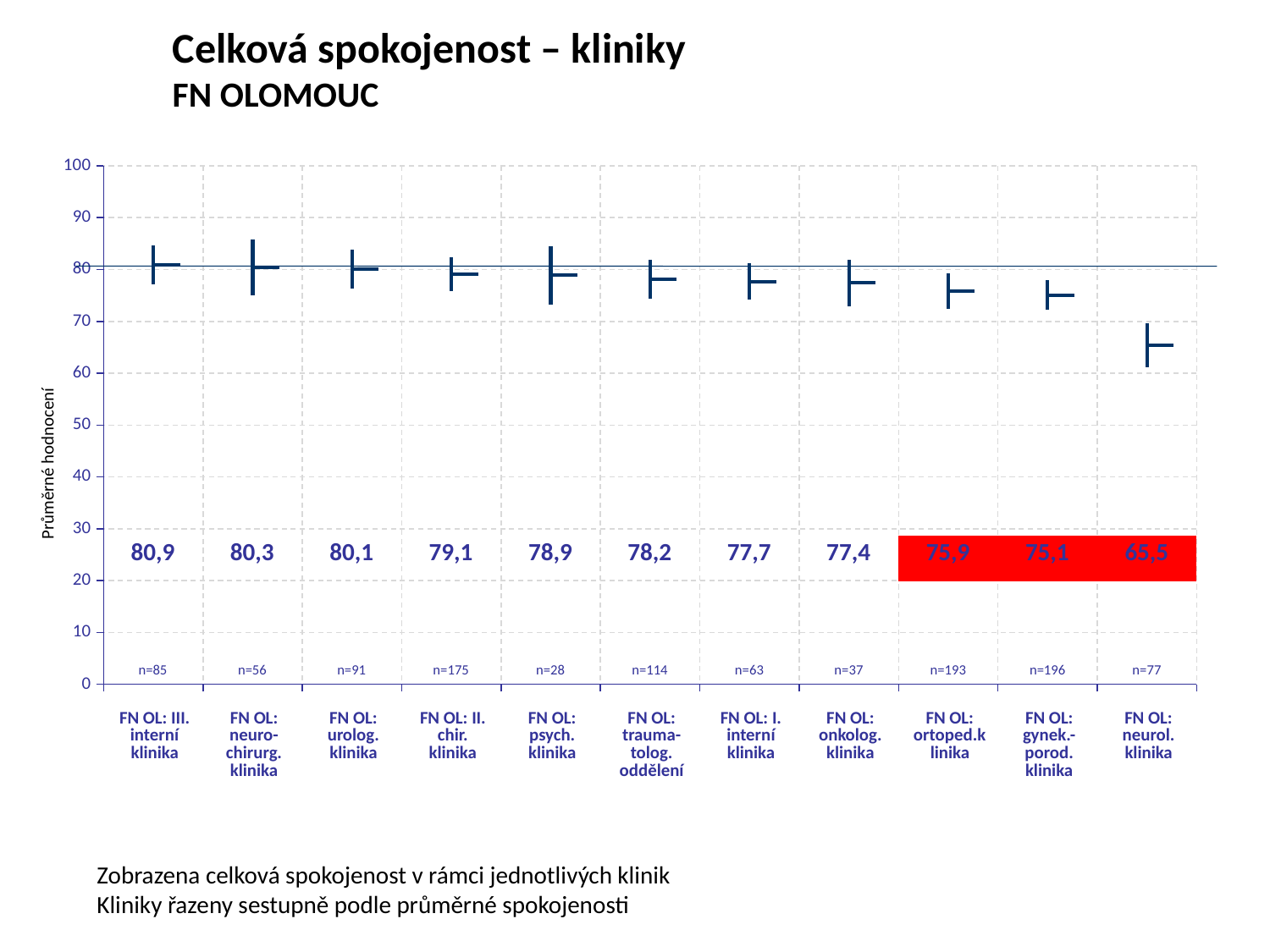
How many clinics have their value labels highlighted with a red background? 3 What is the sample size (n) shown for FN OL: gynek.-porod. klinika? n=196 Is the average rating for FN OL: neurol. klinika greater or less than 70? less Do the average ratings rise or fall from left to right along the x axis? fall What is the average rating (průměrné hodnocení) for FN OL: III. interní klinika? 80,9 Which clinic has the highest average rating? FN OL: III. interní klinika What is the average rating for FN OL: neurol. klinika? 65,5 What is the difference between the average ratings of FN OL: III. interní klinika and FN OL: neurol. klinika? 15,4 What is the average rating for FN OL: psych. klinika? 78,9 How many clinics are shown on the chart? 11 Which clinic has the lowest average rating? FN OL: neurol. klinika Which has a higher average rating, FN OL: onkolog. klinika or FN OL: ortoped. klinika? FN OL: onkolog. klinika